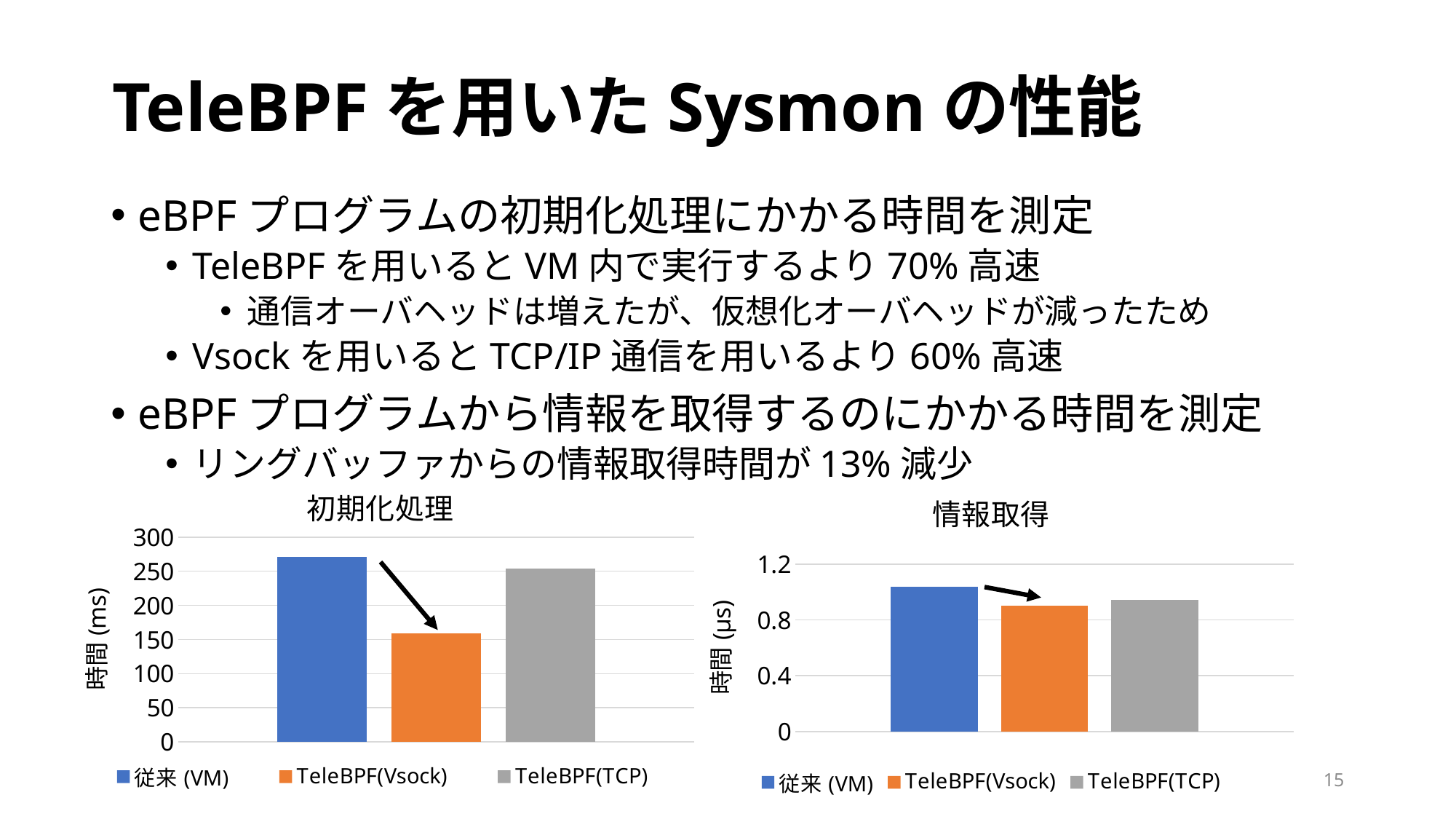
What is the y-axis label of the 情報取得 chart? 時間 (μs) In the 初期化処理 chart, which is larger, the value for TeleBPF(TCP) or TeleBPF(Vsock)? TeleBPF(TCP) In the 初期化処理 chart, is the value for TeleBPF(Vsock) greater or less than 200? less In the 情報取得 chart on the right, which series has the highest value? 従来 (VM) In the 初期化処理 chart, which series has the lowest value? TeleBPF(Vsock) In the 初期化処理 chart, is the value for 従来 (VM) greater or less than 250? greater What is the y-axis label of the 初期化処理 chart? 時間 (ms) In the 情報取得 chart, is the value for 従来 (VM) greater or less than 0.8? greater In the 情報取得 chart, which is larger, the value for 従来 (VM) or TeleBPF(Vsock)? 従来 (VM) What kind of chart is the 初期化処理 chart on the left? bar chart In the 初期化処理 chart, which series has the highest value? 従来 (VM) How many series does the legend of the 初期化処理 chart list? 3